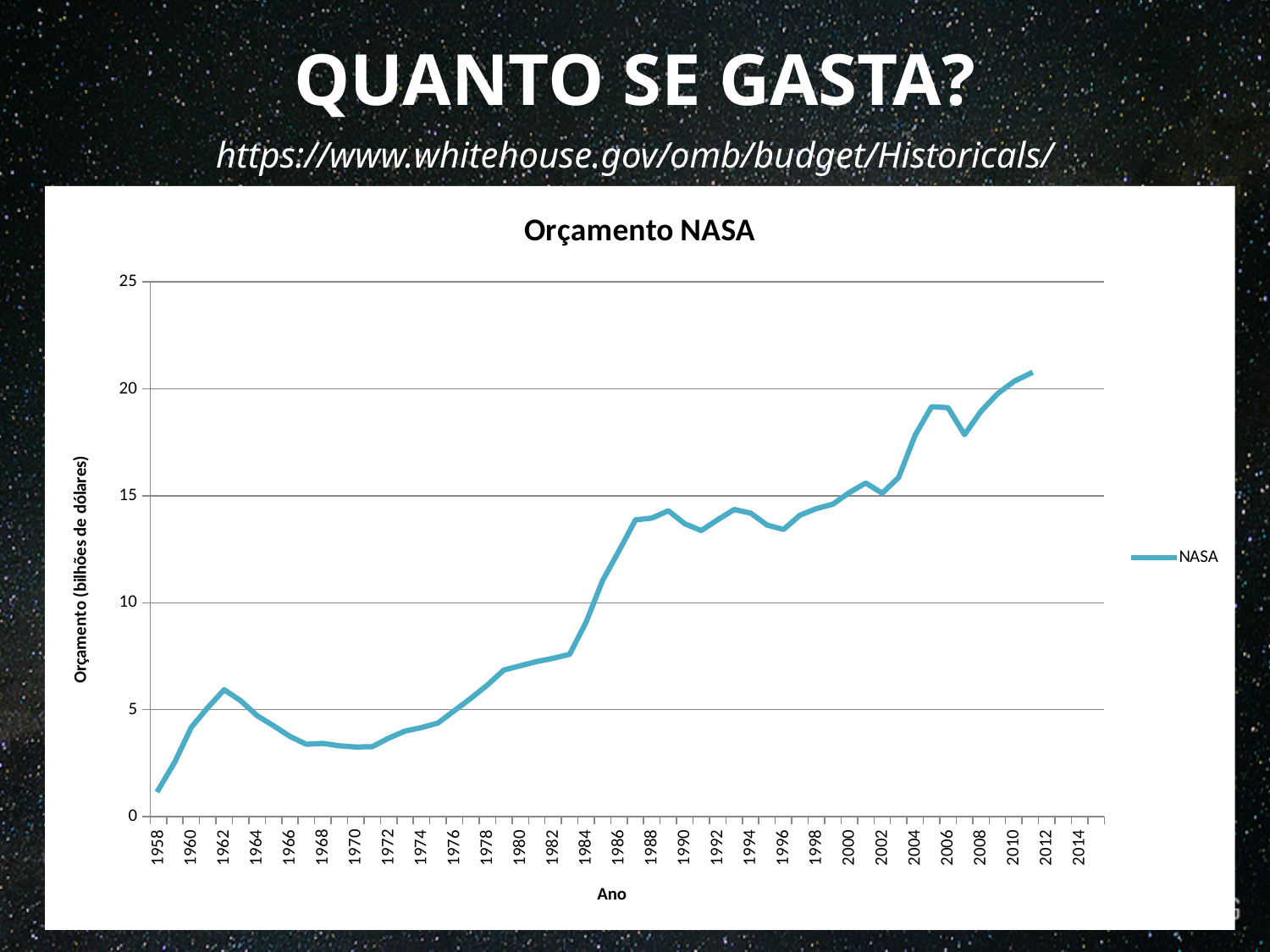
What is the title of the chart? Orçamento NASA Overall, does the NASA budget rise or fall from 1958 to the end of the series? rise Is the NASA budget value for 1988 greater or less than 10? greater Is the NASA budget value for 1962 greater or less than 5? greater What kind of chart is shown on the slide? line chart Is the NASA budget value for 2006 greater or less than 15? greater Which is larger, the NASA budget value for 1962 or for 1970? 1962 How many series does the legend list? 1 What is the label of the vertical axis? Orçamento (bilhões de dólares) Which year has the lowest NASA budget value on the chart? 1958